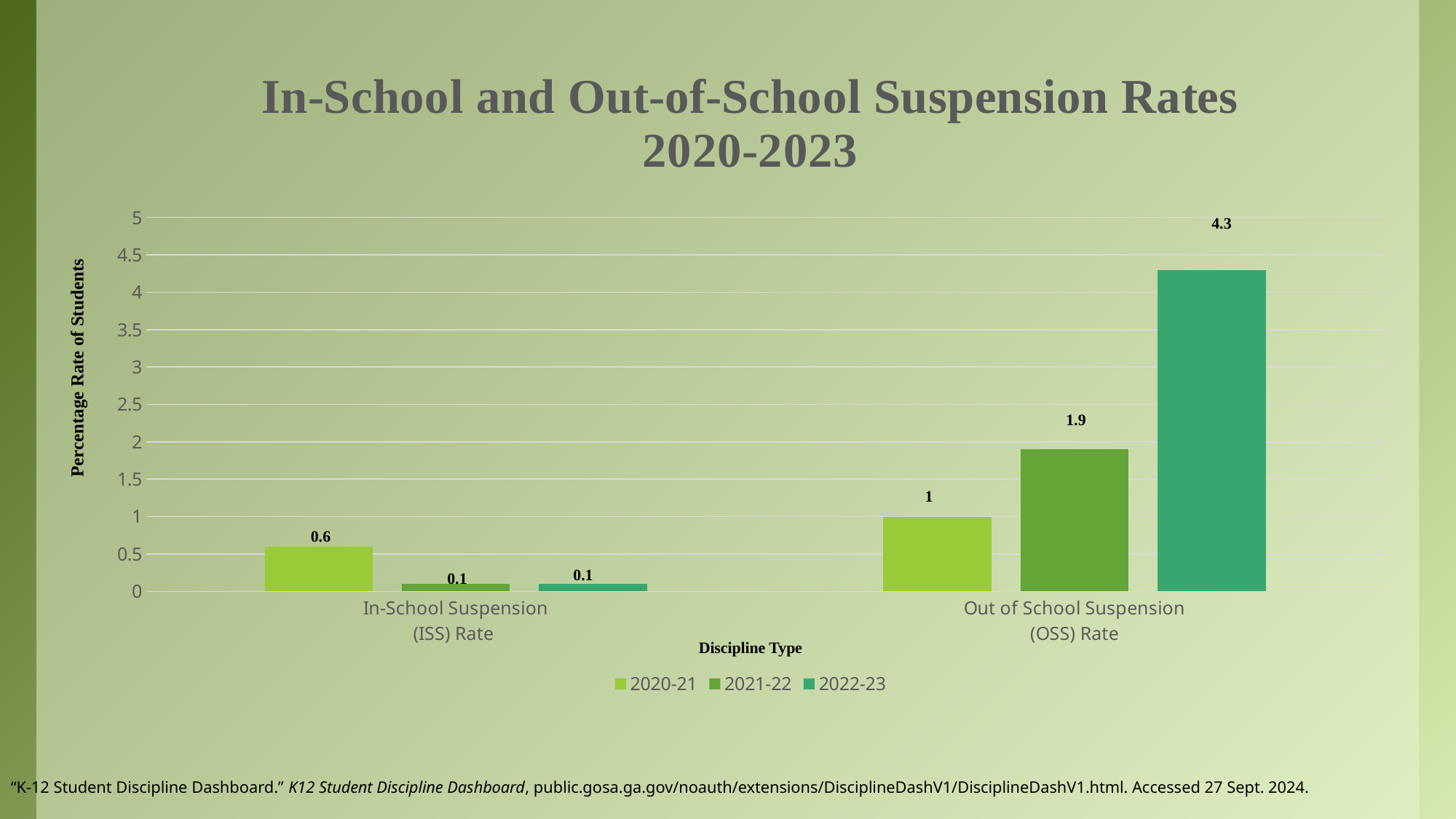
Which series has the highest Out of School Suspension (OSS) Rate? 2022-23 What is the In-School Suspension (ISS) Rate for 2020-21? 0.6 What is the difference between the 2022-23 and 2021-22 Out of School Suspension (OSS) Rates? 2.4 What is the Out of School Suspension (OSS) Rate for 2021-22? 1.9 What is the Out of School Suspension (OSS) Rate for 2022-23? 4.3 What kind of chart is shown on the slide? Bar chart How many series does the legend list? 3 Which series has the highest In-School Suspension (ISS) Rate? 2020-21 What is the difference between the 2020-21 and 2021-22 In-School Suspension (ISS) Rates? 0.5 What is the label of the y axis? Percentage Rate of Students What is the In-School Suspension (ISS) Rate for 2022-23? 0.1 Which is larger: the 2020-21 Out of School Suspension (OSS) Rate or the 2020-21 In-School Suspension (ISS) Rate? Out of School Suspension (OSS) Rate